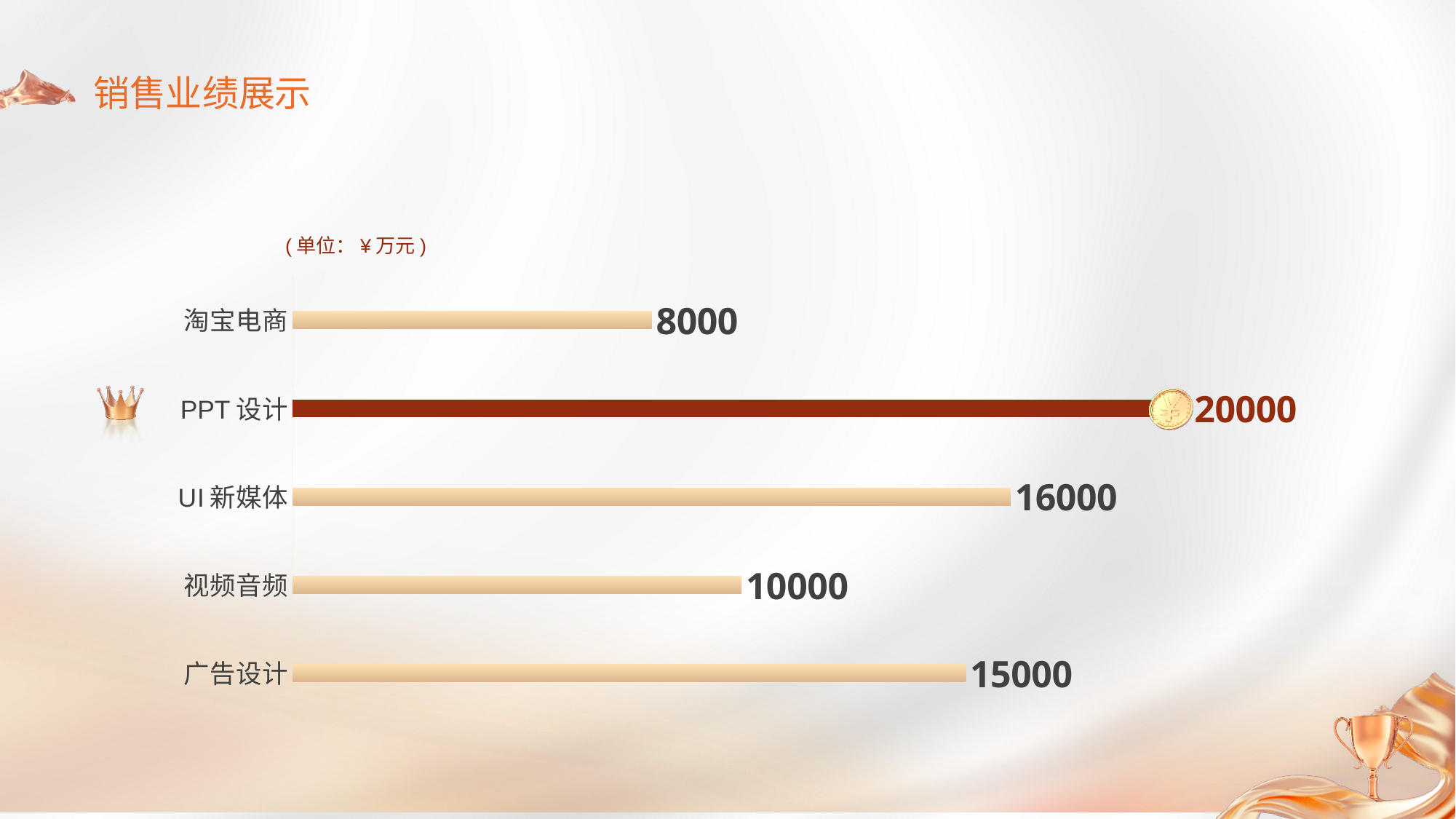
Which is larger, the value for UI 新媒体 or the value for 广告设计? UI 新媒体 What is the value for 视频音频? 10000 What is the difference between the values for PPT 设计 and 淘宝电商? 12000 Which category has the highest value? PPT 设计 What is the value for 淘宝电商? 8000 Which category has the lowest value? 淘宝电商 What is the value for PPT 设计? 20000 How many categories are shown in the chart? 5 What unit is stated for the chart values? ￥万元 What is the value for 广告设计? 15000 What is the value for UI 新媒体? 16000 What kind of chart is shown on the slide? bar chart